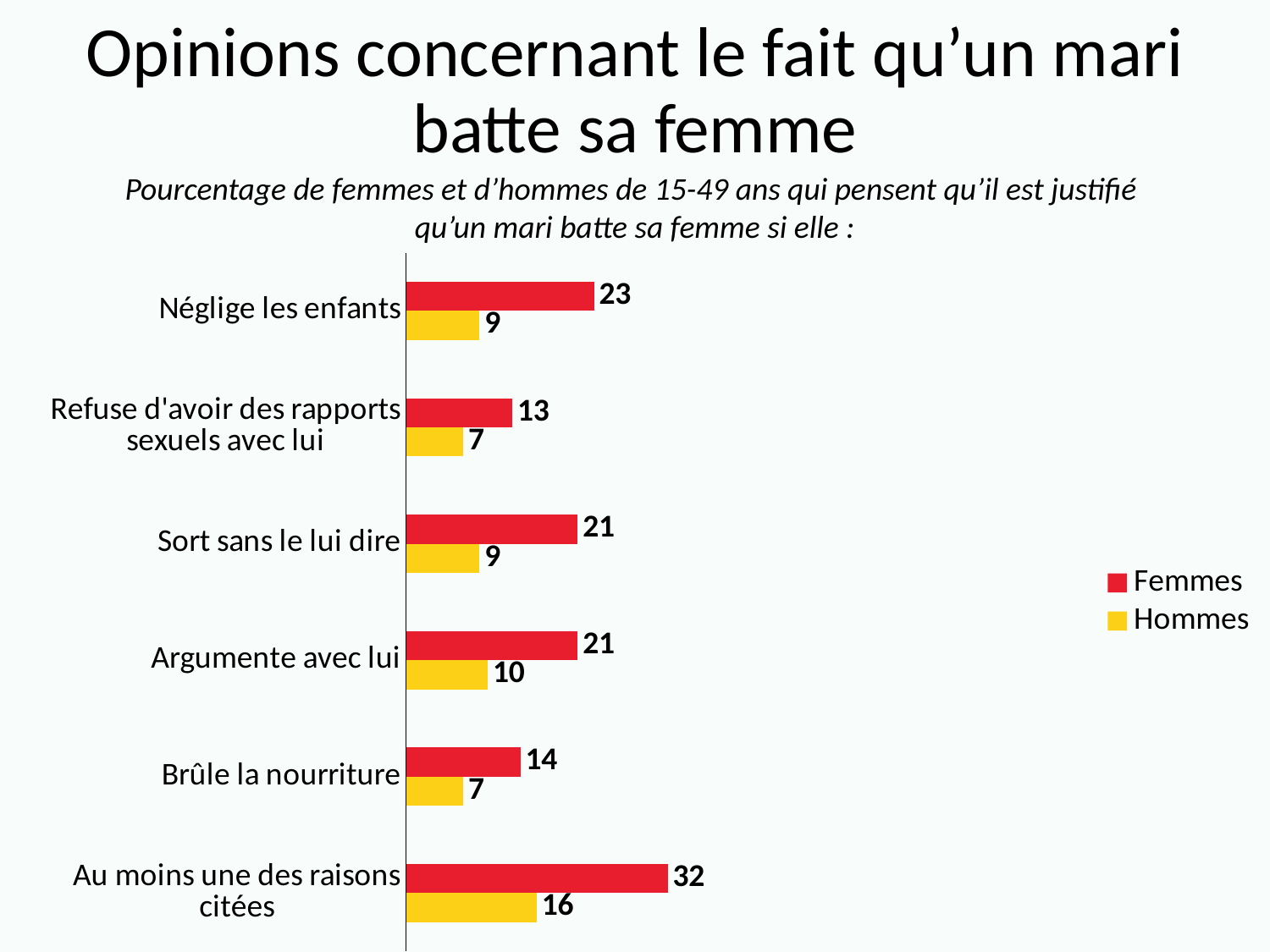
Which category has the highest value for Femmes? Au moins une des raisons citées What is the difference between the Femmes and Hommes values for 'Brûle la nourriture'? 7 How many categories are shown in the chart? 6 Which is larger: the Femmes value for 'Brûle la nourriture' or the Femmes value for 'Refuse d'avoir des rapports sexuels avec lui'? Brûle la nourriture What is the difference between the Femmes values for 'Néglige les enfants' and 'Sort sans le lui dire'? 2 How many series does the legend list? 2 What is the value for Hommes for 'Argumente avec lui'? 10 Which colour represents the Hommes series? Yellow What kind of chart is shown on the slide? Bar chart What is the value for Femmes for 'Néglige les enfants'? 23 Which category has the lowest value for Femmes? Refuse d'avoir des rapports sexuels avec lui What is the value for Hommes for 'Au moins une des raisons citées'? 16